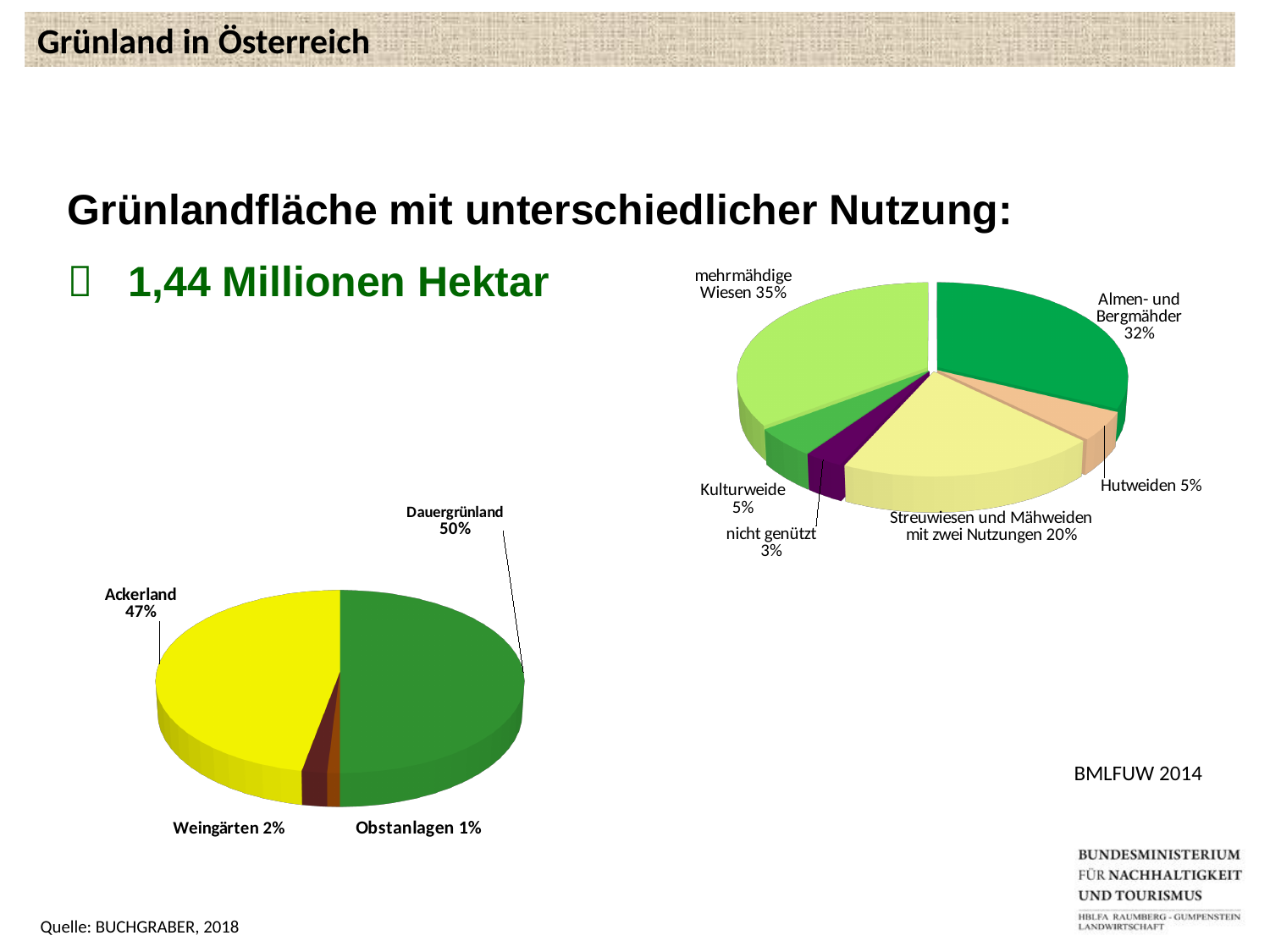
In the pie chart at the bottom left of the slide, which category has the smallest share? Obstanlagen In the pie chart at the bottom left of the slide, what share does Ackerland have? 47% In the pie chart at the top right of the slide, what share do Almen- und Bergmähder have? 32% In the pie chart at the top right of the slide, which category has the largest share? mehrmähdige Wiesen In the pie chart at the top right of the slide, which is larger: the share of Streuwiesen und Mähweiden mit zwei Nutzungen or the share of Hutweiden? Streuwiesen und Mähweiden mit zwei Nutzungen In the pie chart at the bottom left of the slide, what is the difference between the shares of Dauergrünland and Ackerland? 3 percentage points In the pie chart at the bottom left of the slide, how many slices are there? 4 In the pie chart at the top right of the slide, how many slices are there? 6 In the pie chart at the top right of the slide, what share do mehrmähdige Wiesen have? 35% In the pie chart at the bottom left of the slide, what share does Dauergrünland have? 50% What kind of chart is shown at the top right of the slide? Pie chart In the pie chart at the top right of the slide, which category has the smallest share? nicht genützt